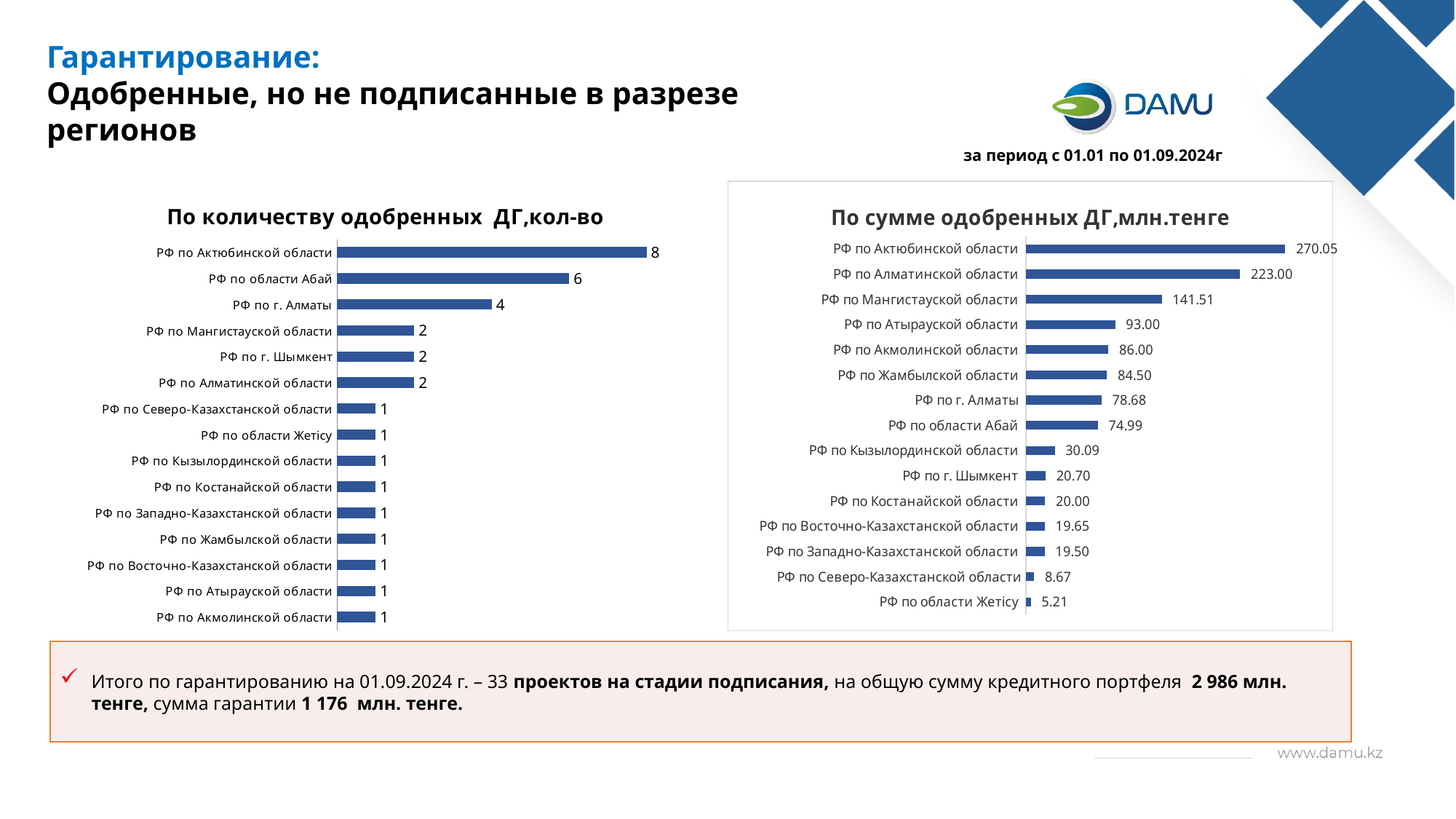
In the chart 'По сумме одобренных ДГ,млн.тенге', what is the value for РФ по Жамбылской области? 84.50 In the chart 'По количеству одобренных ДГ,кол-во', what is the value for РФ по Актюбинской области? 8 What type of chart is 'По сумме одобренных ДГ,млн.тенге'? Bar chart In the chart 'По сумме одобренных ДГ,млн.тенге', what is the difference between РФ по Актюбинской области and РФ по Мангистауской области? 128.54 What is the title of the chart on the left side of the slide? По количеству одобренных ДГ,кол-во In the chart 'По сумме одобренных ДГ,млн.тенге', which is larger: РФ по Атырауской области or РФ по Акмолинской области? РФ по Атырауской области In the chart 'По сумме одобренных ДГ,млн.тенге', which region has the lowest value? РФ по области Жетісу In the chart 'По сумме одобренных ДГ,млн.тенге', what is the value for РФ по Алматинской области? 223.00 In the chart 'По количеству одобренных ДГ,кол-во', what is the value for РФ по г. Алматы? 4 In the chart 'По количеству одобренных ДГ,кол-во', what is the difference between РФ по области Абай and РФ по Мангистауской области? 4 How many categories are shown in the chart 'По количеству одобренных ДГ,кол-во'? 15 In the chart 'По количеству одобренных ДГ,кол-во', which region has the highest value? РФ по Актюбинской области